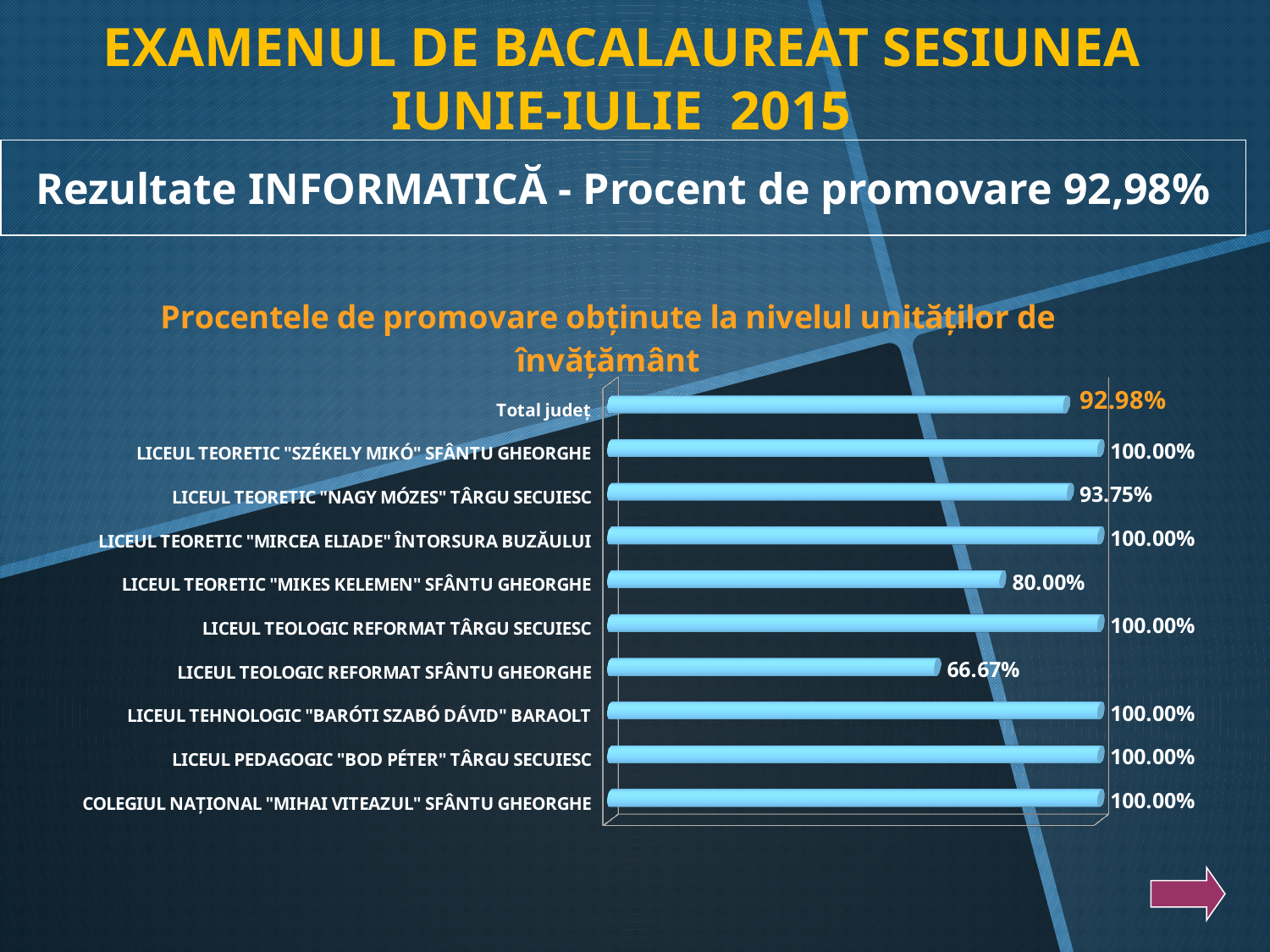
What is the difference between the value for LICEUL TEORETIC "SZÉKELY MIKÓ" SFÂNTU GHEORGHE and the value for Total județ? 7.02% How many bars are plotted in the chart? 10 What is the value for Total județ? 92.98% What kind of chart is shown on the slide? Bar chart What is the value for LICEUL TEOLOGIC REFORMAT SFÂNTU GHEORGHE? 66.67% What is the title of the chart? Procentele de promovare obținute la nivelul unităților de învățământ What is the value for LICEUL TEORETIC "NAGY MÓZES" TÂRGU SECUIESC? 93.75% What is the difference between the value for LICEUL TEORETIC "MIKES KELEMEN" SFÂNTU GHEORGHE and the value for LICEUL TEOLOGIC REFORMAT SFÂNTU GHEORGHE? 13.33% What is the value for LICEUL PEDAGOGIC "BOD PÉTER" TÂRGU SECUIESC? 100.00% Which is larger: the value for LICEUL TEORETIC "NAGY MÓZES" TÂRGU SECUIESC or the value for Total județ? LICEUL TEORETIC "NAGY MÓZES" TÂRGU SECUIESC Which category has the lowest value? LICEUL TEOLOGIC REFORMAT SFÂNTU GHEORGHE What is the value for LICEUL TEORETIC "MIKES KELEMEN" SFÂNTU GHEORGHE? 80.00%